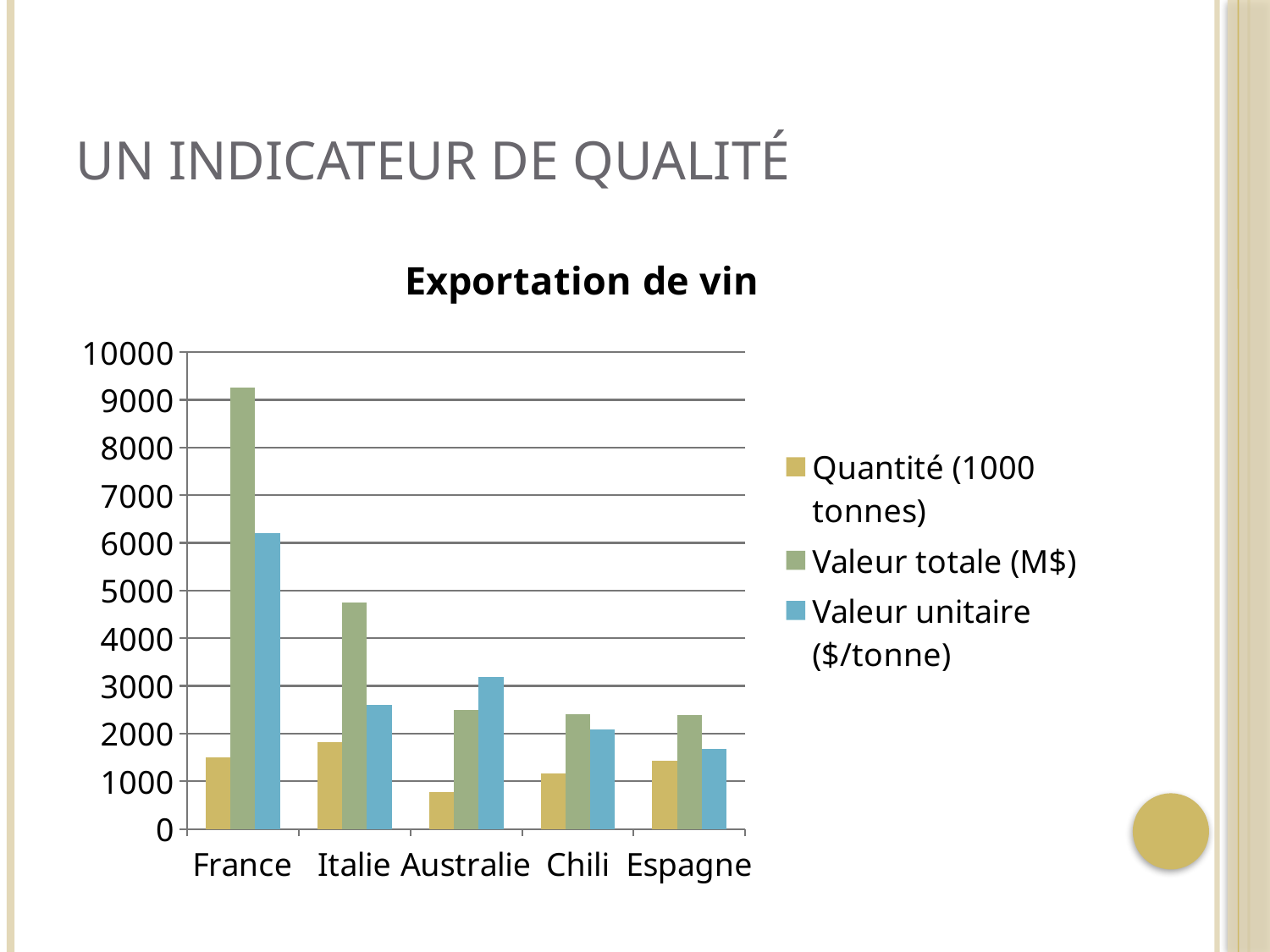
Which country has the highest Valeur totale (M$)? France Which country has the lowest Quantité (1000 tonnes)? Australie Which country has the highest Valeur unitaire ($/tonne)? France What is the title of the chart? Exportation de vin How many series does the legend list? 3 Which is larger for Australie: Valeur totale (M$) or Valeur unitaire ($/tonne)? Valeur unitaire ($/tonne) How many countries are shown on the x axis? 5 What type of chart is shown on the slide? Bar chart Which country has a larger Quantité (1000 tonnes): Italie or Chili? Italie Is the Valeur unitaire ($/tonne) for Australie greater or less than 3000? greater Which country has the lowest Valeur unitaire ($/tonne)? Espagne Is the Valeur totale (M$) for France greater or less than 9000? greater